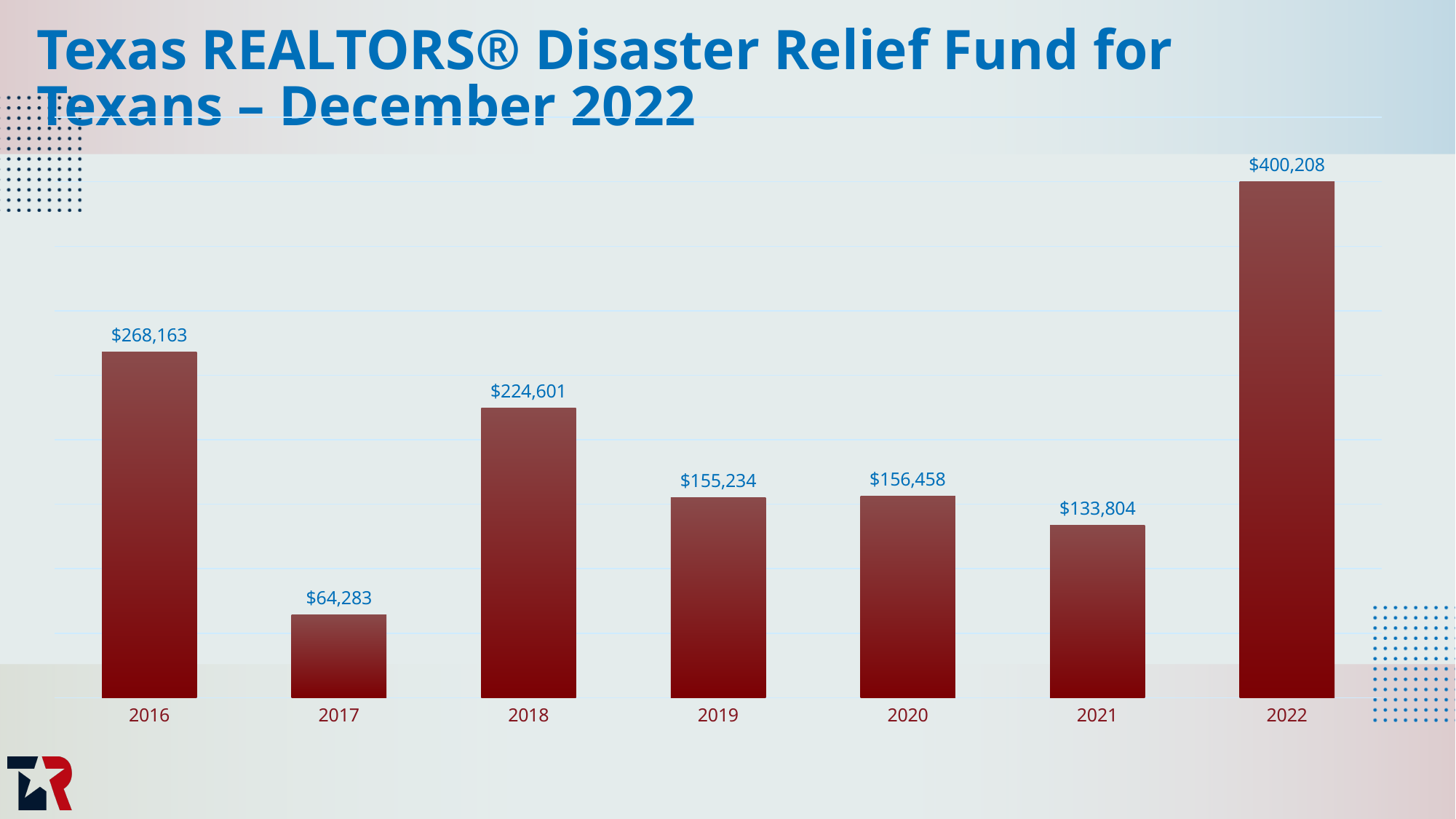
What kind of chart is shown on the slide? Bar chart What is the value for 2019? $155,234 Which year has the lowest value? 2017 What is the value for 2017? $64,283 What is the difference between the values for 2022 and 2016? $132,045 What is the difference between the values for 2016 and 2017? $203,880 Which is larger, the value for 2018 or the value for 2021? 2018 How many years are shown on the x axis? 7 What is the value for 2022? $400,208 What is the value for 2021? $133,804 Which year has the highest value? 2022 Does the value rise or fall from 2021 to 2022? Rise